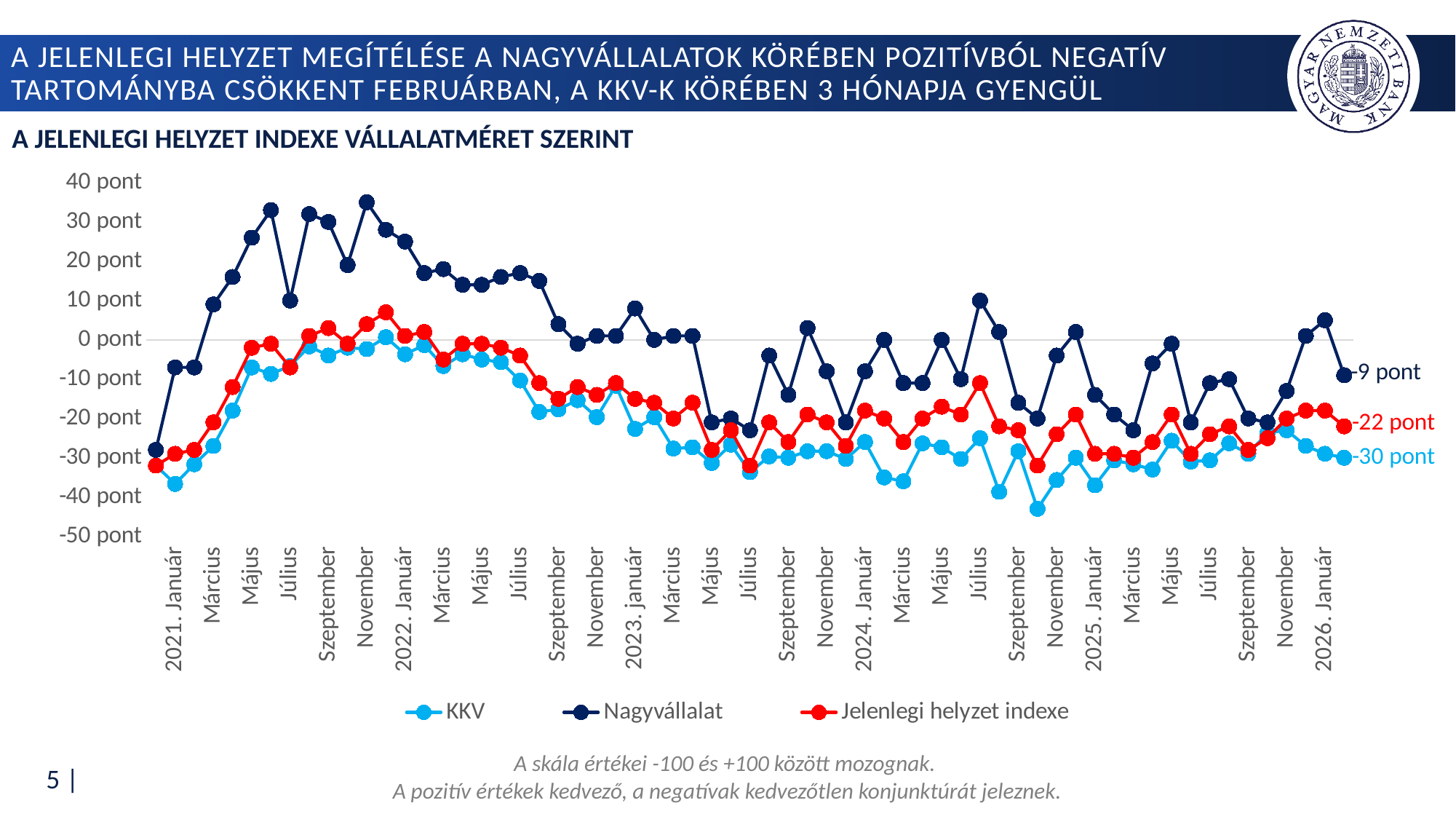
How many series does the legend list? 3 At the last data point, which series is higher: Nagyvállalat or KKV? Nagyvállalat Is the value for Nagyvállalat in November 2021 greater or less than 20 pont? greater Is the value for Nagyvállalat in 2021. Január greater or less than -20 pont? greater What is the title of the chart? A JELENLEGI HELYZET INDEXE VÁLLALATMÉRET SZERINT What is the latest labelled value for the Jelenlegi helyzet indexe series? -22 pont What is the difference between the latest labelled values of Nagyvállalat and KKV? 21 pont What is the latest labelled value for the Nagyvállalat series? -9 pont What is the latest labelled value for the KKV series? -30 pont What is the difference between the latest labelled values of Jelenlegi helyzet indexe and KKV? 8 pont Which series has the highest value at the last data point? Nagyvállalat What kind of chart is shown on the slide? line chart